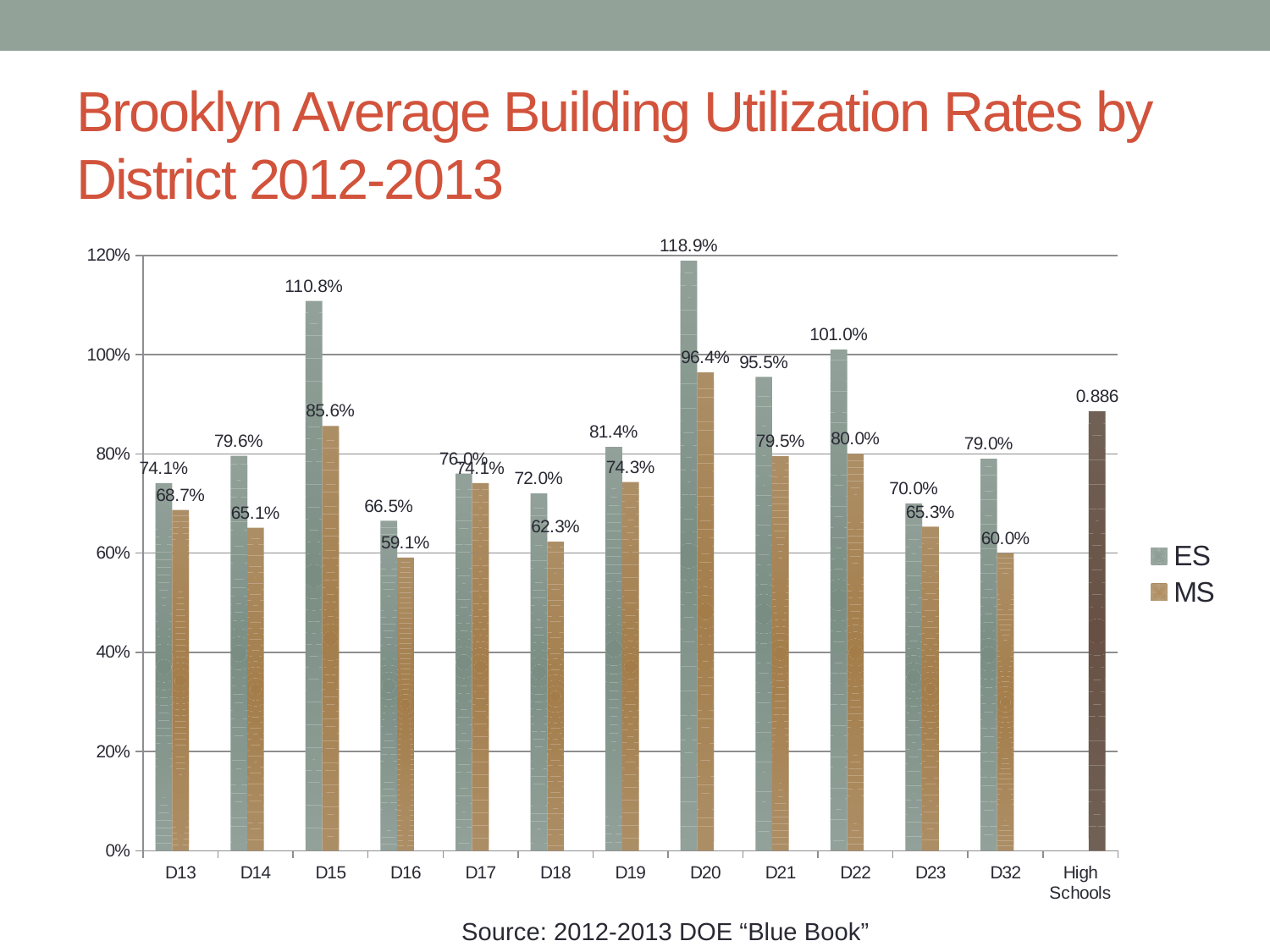
What is the difference between the ES and MS values for D22? 21.0% Which district has the lowest MS utilization rate? D16 Which district has the lowest ES utilization rate? D16 Which is larger: the MS value for D15 or the ES value for D19? MS value for D15 What is the ES value for D20? 118.9% How many series does the legend list? 2 What kind of chart is shown on the slide? bar chart Which district has the highest ES utilization rate? D20 What is the MS value for D15? 85.6% What value is labeled on the High Schools bar? 0.886 Is the ES value for D21 greater or less than 100%? less How many categories are shown on the x axis? 13